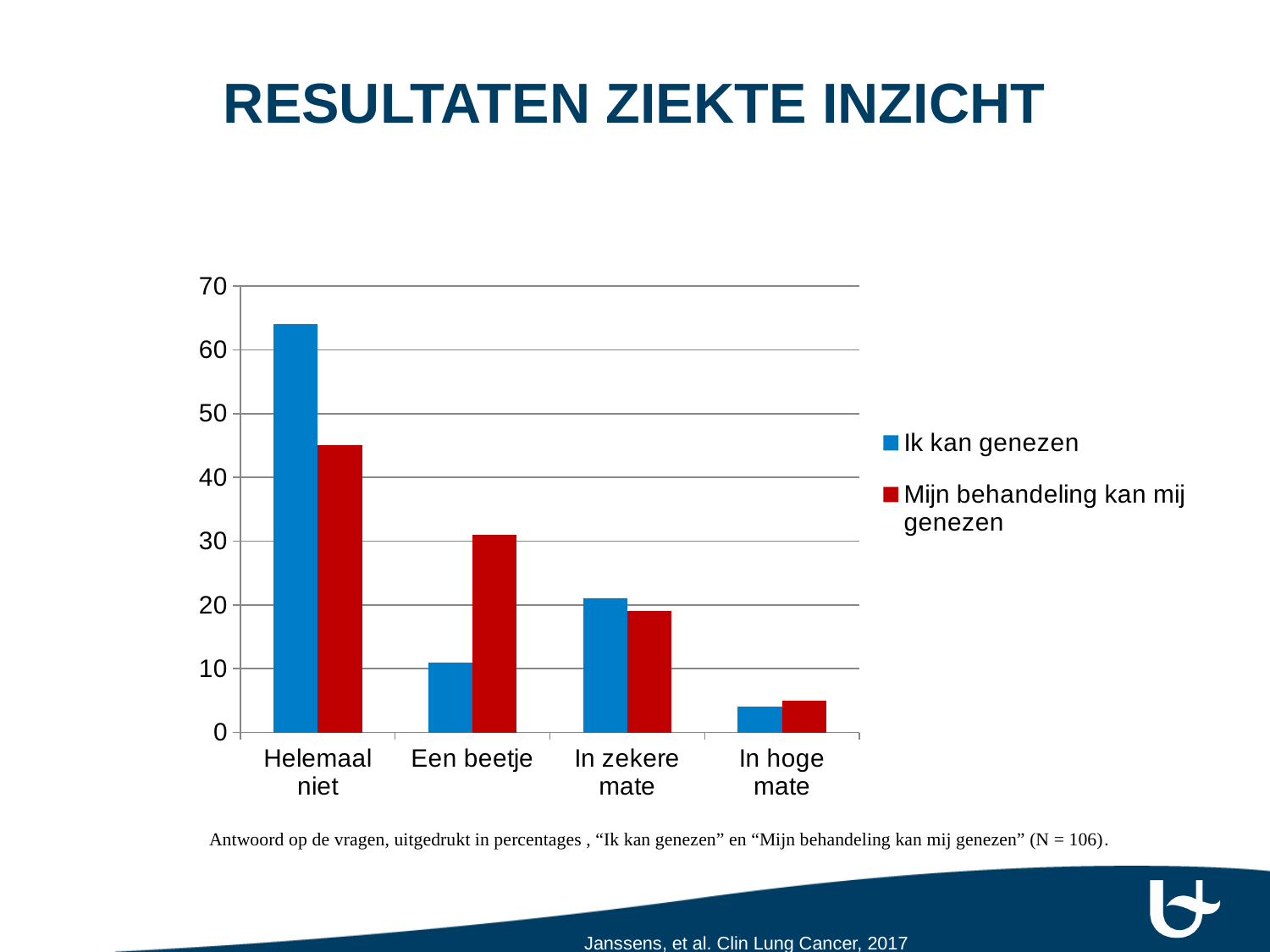
How many series does the legend list? 2 For the category "Een beetje", which series has the larger value: "Ik kan genezen" or "Mijn behandeling kan mij genezen"? Mijn behandeling kan mij genezen How many categories are shown on the x axis? 4 Which category has the lowest value for the series "Ik kan genezen"? In hoge mate What kind of chart is shown on the slide? bar chart Do the values for the series "Mijn behandeling kan mij genezen" rise or fall from left to right along the x axis? fall For the category "Helemaal niet", which series has the larger value: "Ik kan genezen" or "Mijn behandeling kan mij genezen"? Ik kan genezen Which category has the lowest value for the series "Mijn behandeling kan mij genezen"? In hoge mate Which category has the highest value for the series "Ik kan genezen"? Helemaal niet Is the value for "Ik kan genezen" in the category "In hoge mate" greater or less than 10? less Is the value for "Mijn behandeling kan mij genezen" in the category "Een beetje" greater or less than 20? greater Is the value for "Ik kan genezen" in the category "Helemaal niet" greater or less than 60? greater